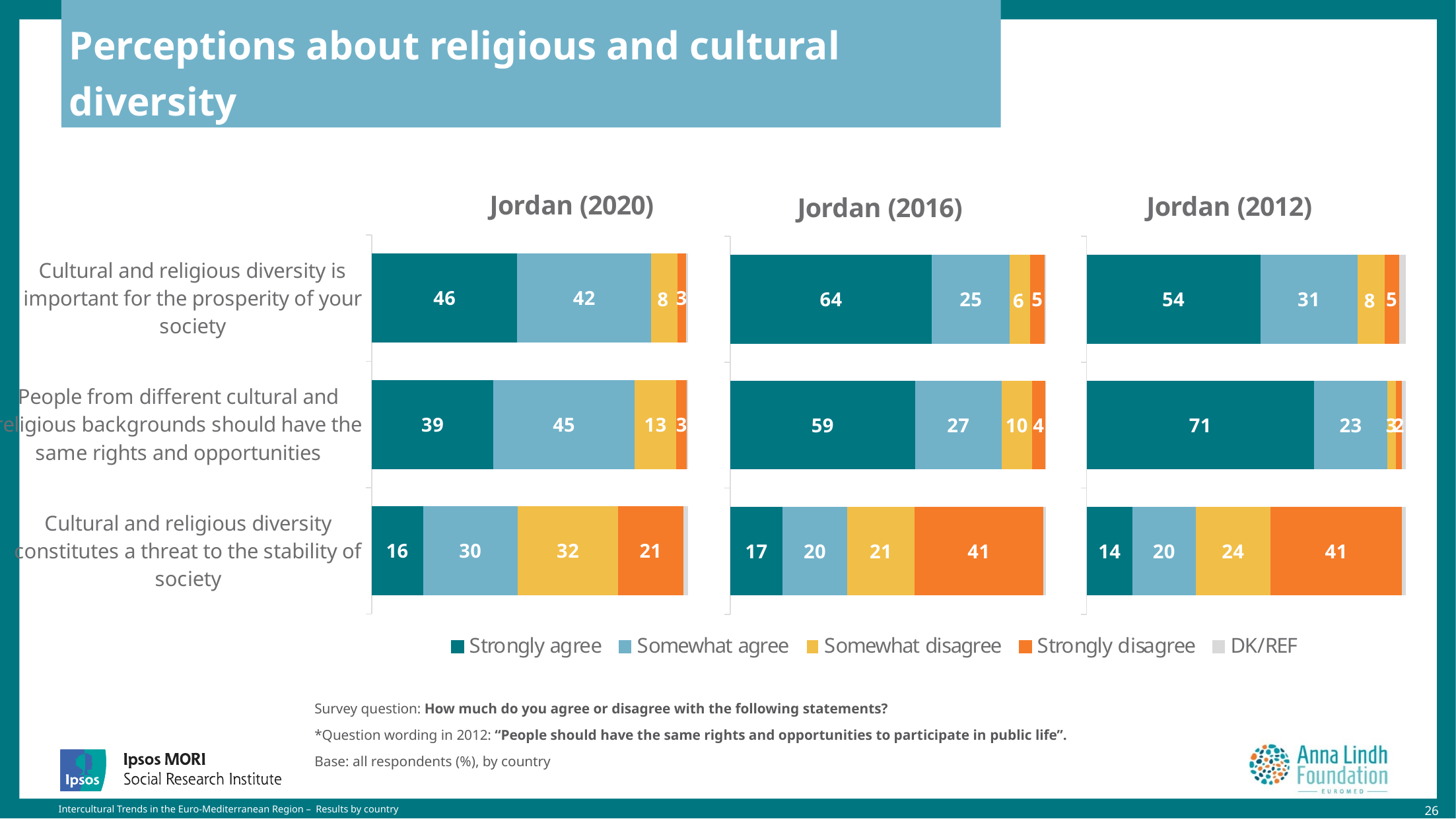
In the Jordan (2012) chart, what is the Strongly agree value for 'People from different cultural and religious backgrounds should have the same rights and opportunities'? 71 In the Jordan (2016) chart, which statement has the highest Strongly agree value? Cultural and religious diversity is important for the prosperity of your society In the Jordan (2020) chart, what is the Somewhat disagree value for 'Cultural and religious diversity constitutes a threat to the stability of society'? 32 In the Jordan (2016) chart, what is the Strongly disagree value for 'Cultural and religious diversity constitutes a threat to the stability of society'? 41 How many statements (categories) are shown in each chart? 3 In the Jordan (2020) chart, what percentage strongly agree that cultural and religious diversity is important for the prosperity of your society? 46 In the Jordan (2012) chart, which statement has the lowest Strongly agree value? Cultural and religious diversity constitutes a threat to the stability of society How many series does the legend list? 5 Is the Somewhat agree value for 'People from different cultural and religious backgrounds should have the same rights and opportunities' larger in the Jordan (2020) chart or the Jordan (2016) chart? Jordan (2020) Which legend entry is shown in orange? Strongly disagree What is the difference between the Strongly agree values for 'Cultural and religious diversity is important for the prosperity of your society' in the Jordan (2016) chart and the Jordan (2020) chart? 18 What kind of chart is used on this slide? Stacked bar chart